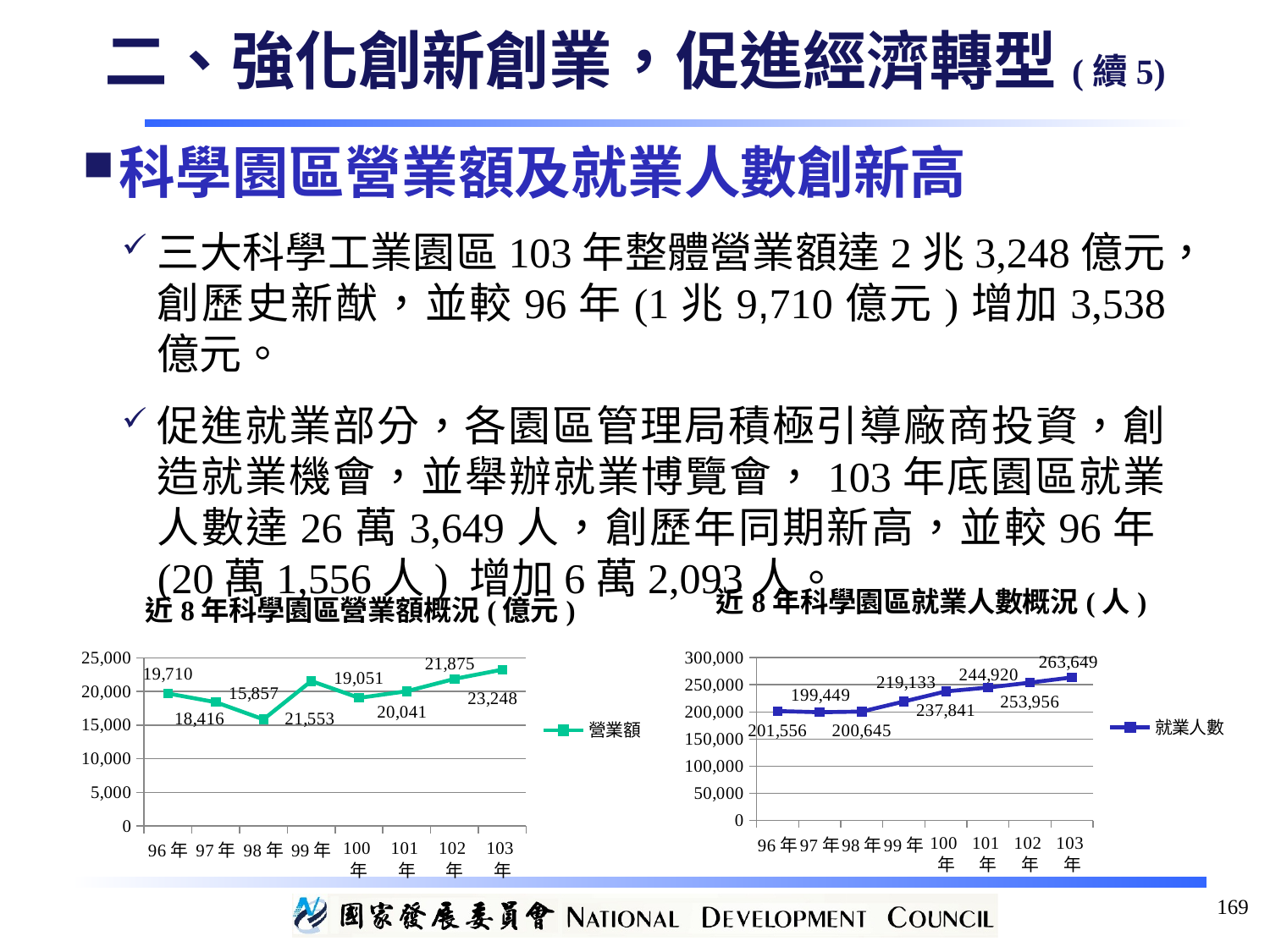
In the chart titled 近8年科學園區營業額概況(億元), which year has the lowest value? 98年 In the chart titled 近8年科學園區就業人數概況(人), do the values generally rise or fall from 98年 to 103年? rise In the chart titled 近8年科學園區營業額概況(億元), what is the difference between the values for 103年 and 96年? 3,538 In the chart titled 近8年科學園區營業額概況(億元), what is the value for 103年? 23,248 In the chart titled 近8年科學園區就業人數概況(人), what is the value for 103年? 263,649 In the chart titled 近8年科學園區就業人數概況(人), which year has the lowest value? 97年 In the chart titled 近8年科學園區就業人數概況(人), what is the value for 100年? 237,841 What type of chart is the chart titled 近8年科學園區就業人數概況(人)? line chart In the chart titled 近8年科學園區就業人數概況(人), what is the difference between the values for 103年 and 96年? 62,093 In the chart titled 近8年科學園區營業額概況(億元), how many data points are plotted? 8 In the chart titled 近8年科學園區營業額概況(億元), which year has the highest value? 103年 In the chart titled 近8年科學園區營業額概況(億元), what is the value for 98年? 15,857